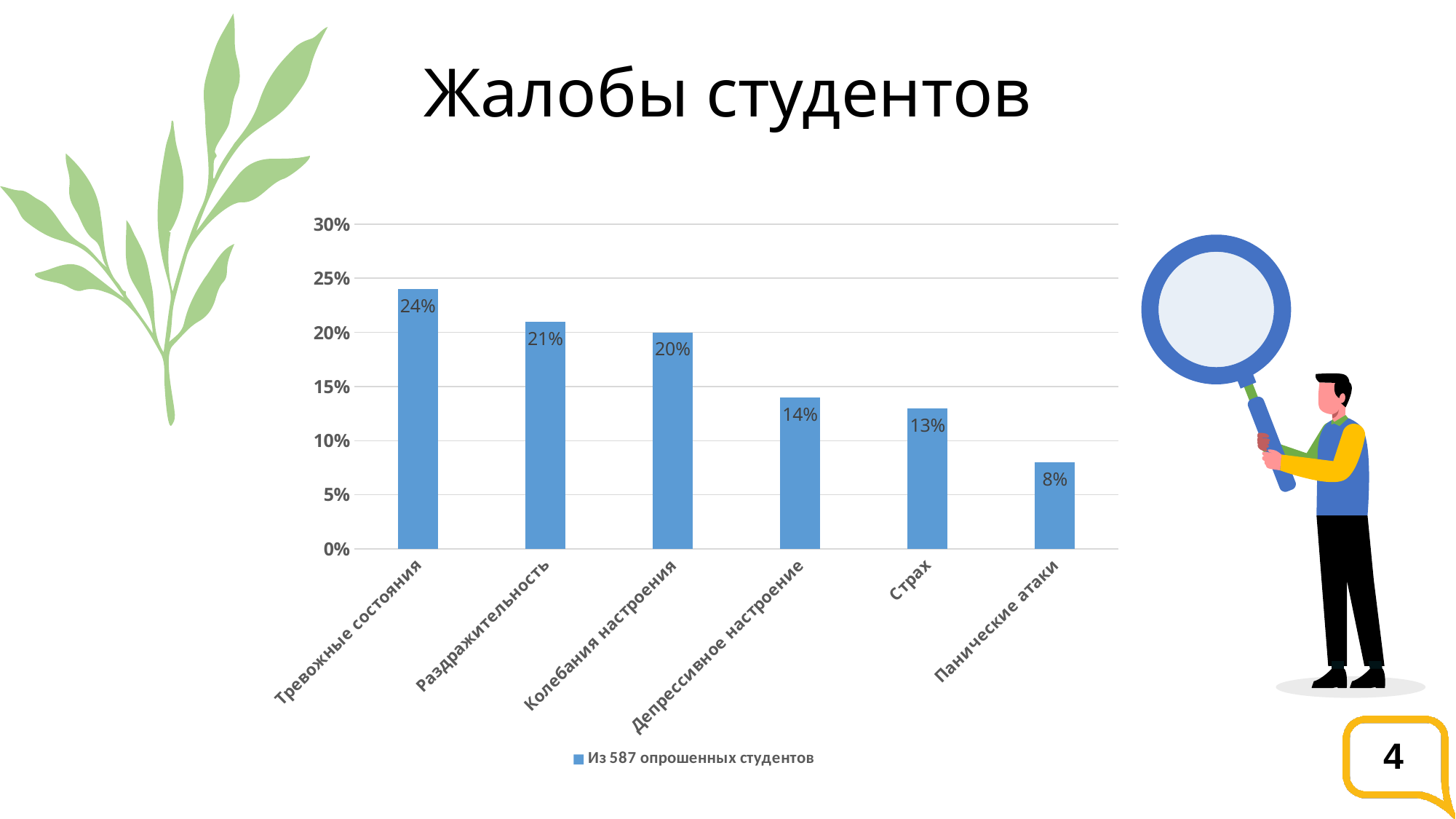
What is the value for Тревожные состояния? 24% What kind of chart is shown on the slide? bar chart How many categories are shown on the x axis? 6 Which category has the lowest value? Панические атаки How many series does the legend list? 1 Is the value for Страх greater or less than 15%? less What is the value for Панические атаки? 8% Which is larger, the value for Колебания настроения or the value for Депрессивное настроение? Колебания настроения What is the legend entry of the chart? Из 587 опрошенных студентов Which category has the highest value? Тревожные состояния What is the value for Депрессивное настроение? 14% What is the difference between the values for Раздражительность and Страх? 8%